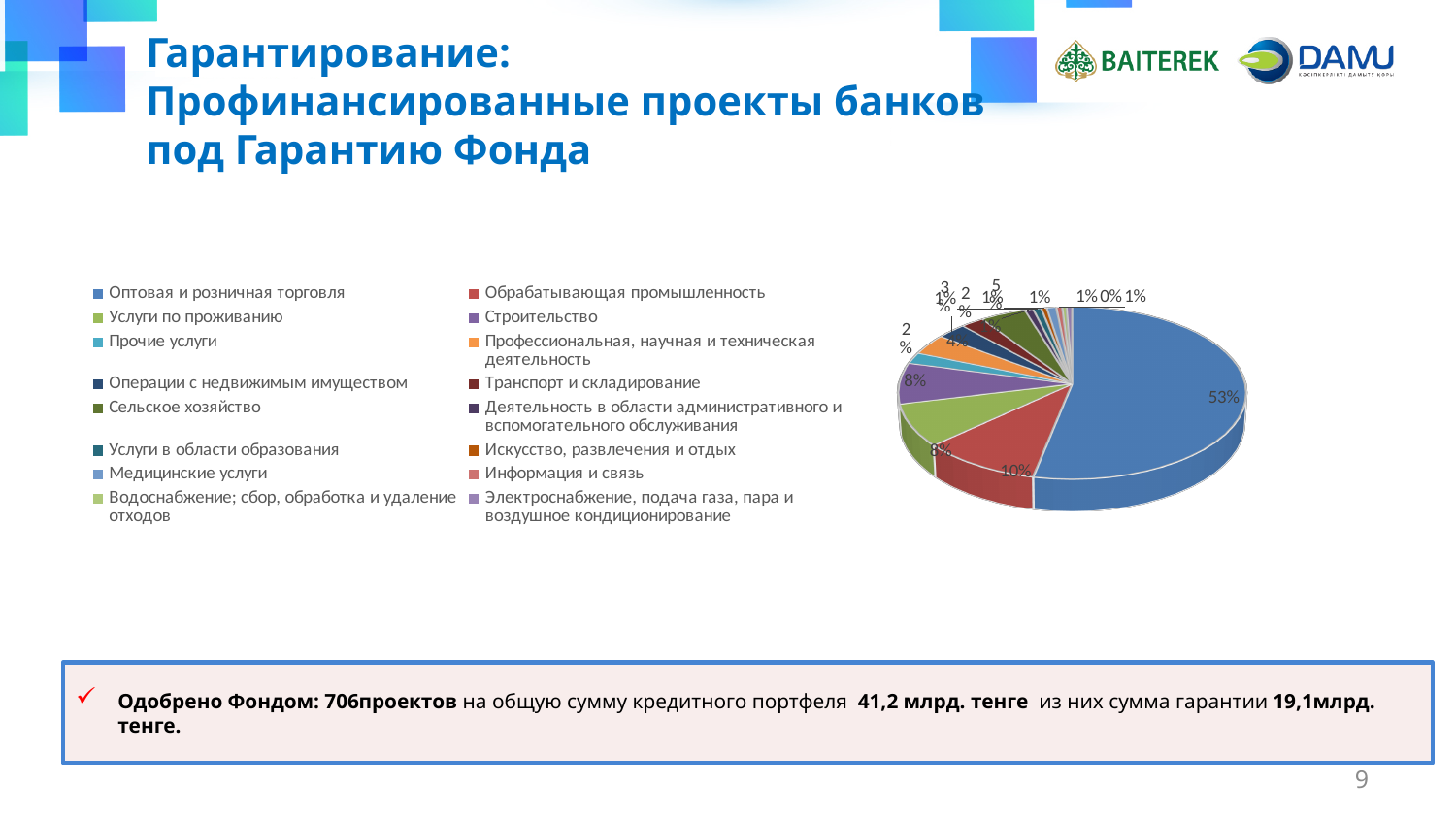
What is the title of the slide containing the pie chart? Гарантирование: Профинансированные проекты банков под Гарантию Фонда Is the share for Оптовая и розничная торговля greater or less than 50%? greater Which category has the largest share of the pie? Оптовая и розничная торговля How many categories does the legend of the pie chart list? 16 Which is larger: the share for Оптовая и розничная торговля or the share for Обрабатывающая промышленность? Оптовая и розничная торговля What is the difference in percentage points between the largest slice (53%) and the red slice (10%)? 43 percentage points What kind of chart is shown on the slide? pie chart What colour is the slice for Оптовая и розничная торговля in the pie chart? blue What share of the pie does Обрабатывающая промышленность (the red slice) represent? 10% What share of the pie does the largest slice represent? 53% What share of the pie does Услуги по проживанию (the green slice) represent? 8% What is the smallest percentage label shown on the pie chart? 0%